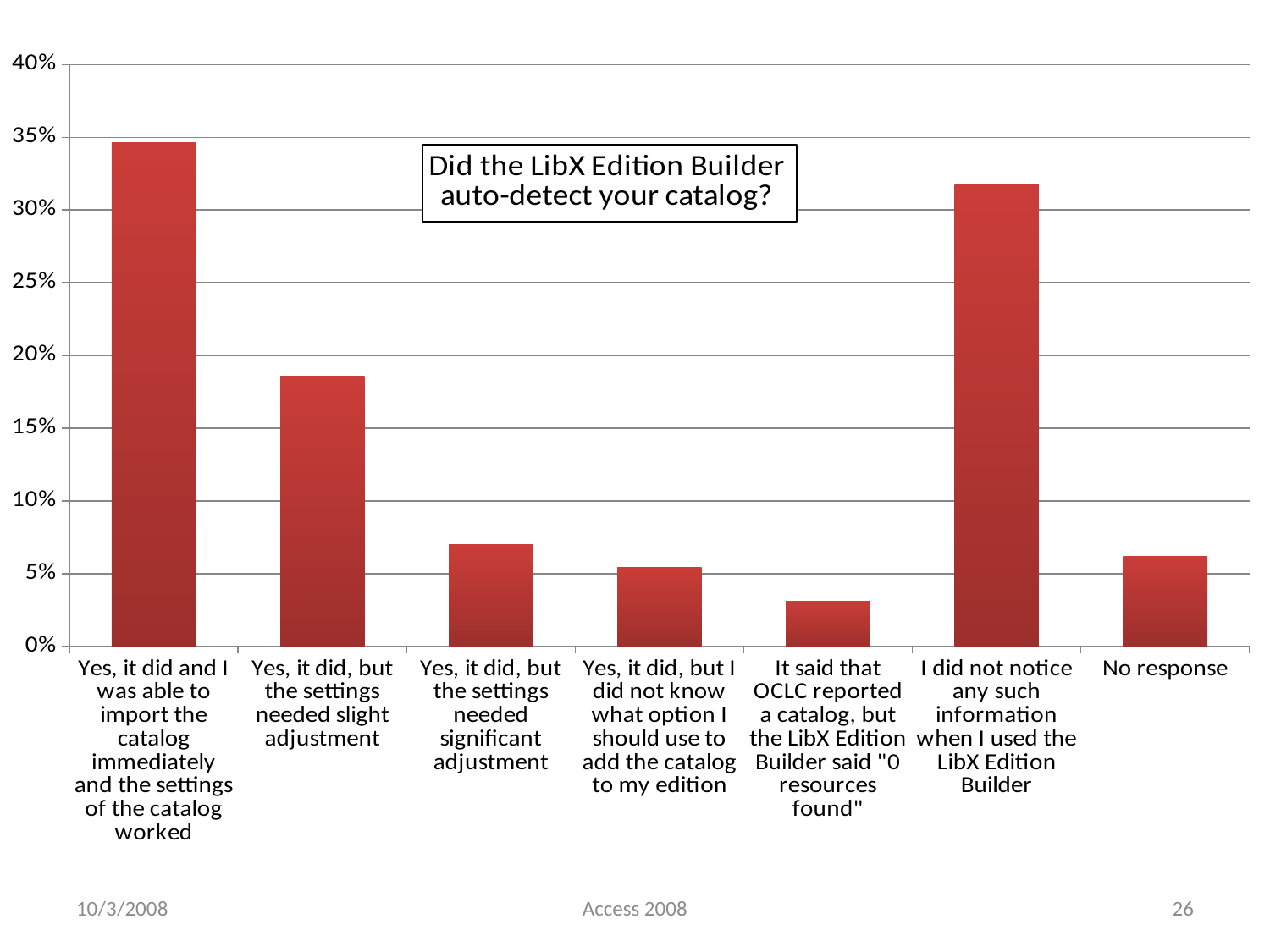
Is the value for "Yes, it did and I was able to import the catalog immediately and the settings of the catalog worked" greater or less than 30%? greater What is the title of the chart? Did the LibX Edition Builder auto-detect your catalog? Is the value for "Yes, it did, but I did not know what option I should use to add the catalog to my edition" greater or less than 10%? less What kind of chart is shown on the slide? bar chart Which response category has the lowest value? It said that OCLC reported a catalog, but the LibX Edition Builder said "0 resources found" How many response categories are shown on the x axis? 7 Is the value for "Yes, it did, but the settings needed slight adjustment" greater or less than 20%? less Which response category has the highest value? Yes, it did and I was able to import the catalog immediately and the settings of the catalog worked Which is larger: the value for "Yes, it did, but the settings needed slight adjustment" or the value for "No response"? Yes, it did, but the settings needed slight adjustment Which is larger: the value for "I did not notice any such information when I used the LibX Edition Builder" or the value for "Yes, it did, but the settings needed significant adjustment"? I did not notice any such information when I used the LibX Edition Builder